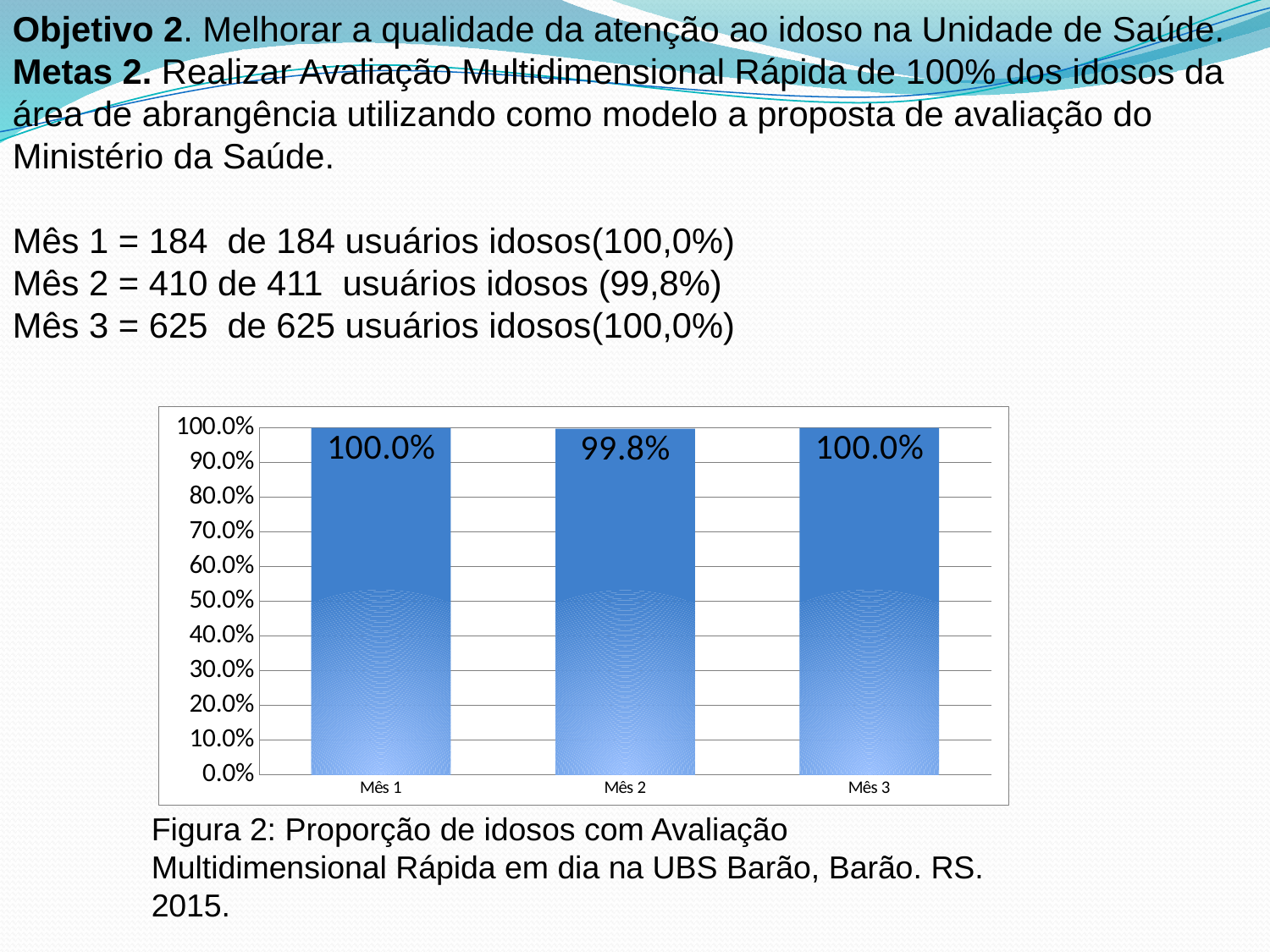
Which month has the lowest value in the chart? Mês 2 Which is larger, the value for Mês 2 or the value for Mês 3? Mês 3 What is the value shown for Mês 2? 99.8% How many categories (months) are shown on the x axis of the chart? 3 Is the value for Mês 2 greater or less than 90.0%? greater What kind of chart is shown on the slide? bar chart What is the highest tick value shown on the y axis of the chart? 100.0% What is the value shown for Mês 1? 100.0% What figure number is given in the caption below the chart? Figura 2 What is the difference between the values for Mês 1 and Mês 2? 0.2% What is the value shown for Mês 3? 100.0%